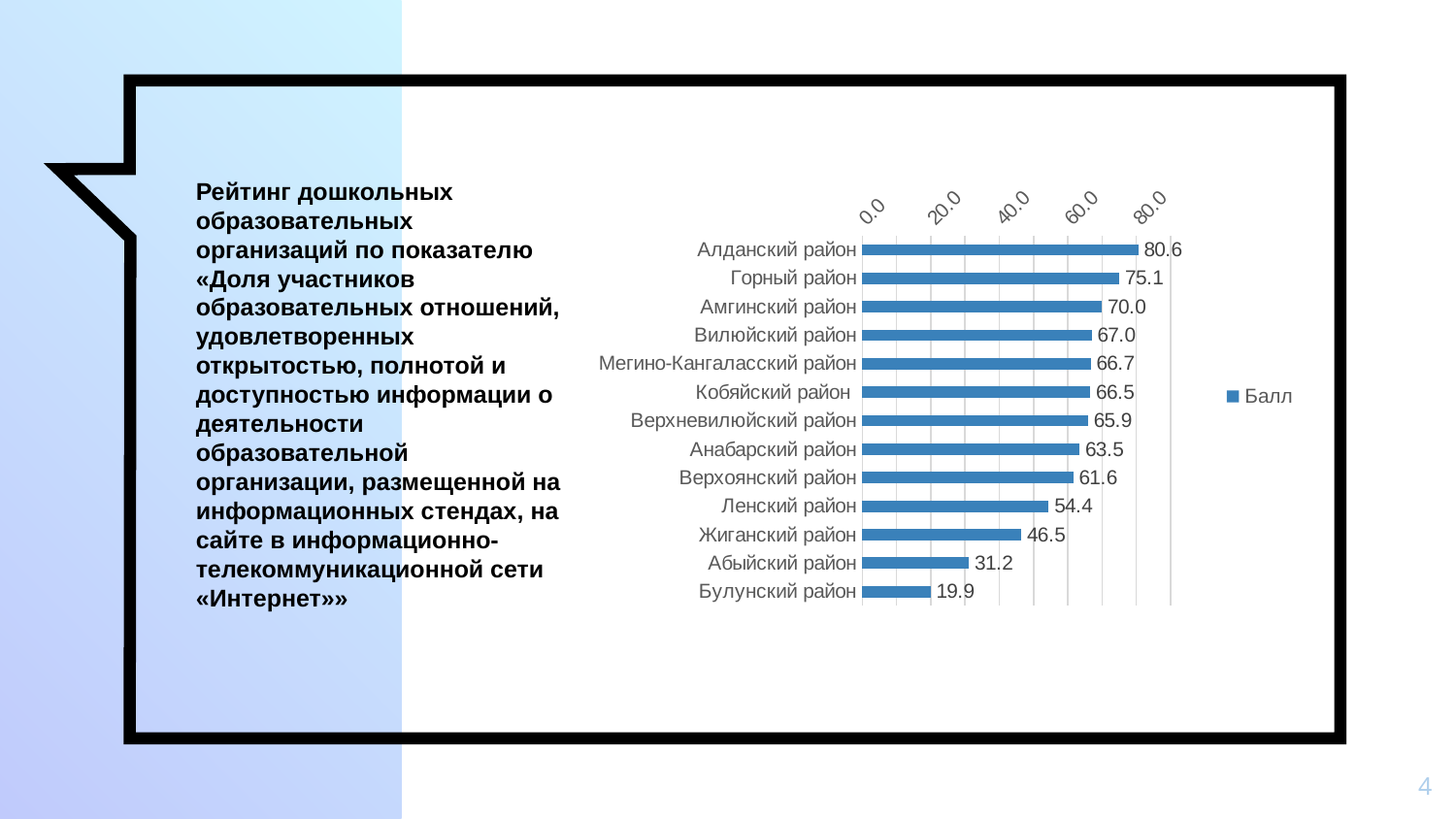
What is the value for Алданский район? 80.6 How many series does the legend list? 1 What is the value for Булунский район? 19.9 What is the value for Мегино-Кангаласский район? 66.7 Is the value for Абыйский район greater or less than 40.0? less Which district has the highest value? Алданский район Which district has the lowest value? Булунский район What kind of chart is shown on the slide? bar chart How many districts are shown in the chart? 13 What is the name of the series in the legend? Балл Which is larger, the value for Ленский район or the value for Жиганский район? Ленский район What is the difference between the values for Алданский район and Горный район? 5.5